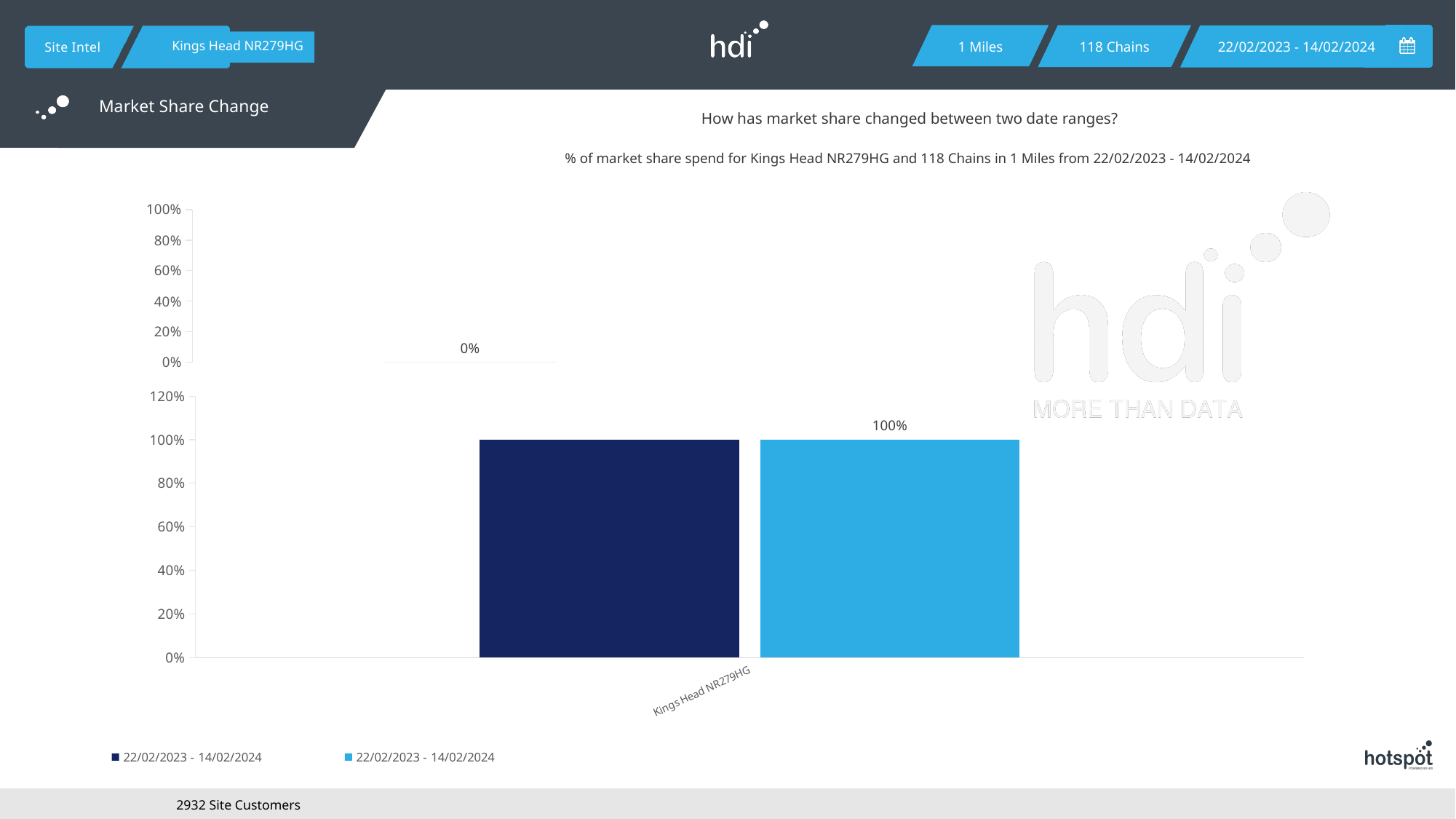
What is the category label shown on the x axis of the lower chart? Kings Head NR279HG In the lower chart, how many bars are plotted for Kings Head NR279HG? 2 In the upper chart, what value is printed as the data label? 0% In the lower chart, is the value of the dark blue bar for Kings Head NR279HG greater or less than 60%? greater In the lower chart, what value is printed above the light blue bar for Kings Head NR279HG? 100% What date range is shown for both entries in the legend? 22/02/2023 - 14/02/2024 In the lower chart, how many categories are shown on the x axis? 1 In the lower chart, is the value of the light blue bar for Kings Head NR279HG greater or less than 80%? greater How many series does the legend at the bottom of the slide list? 2 What kind of chart is the lower chart on the slide? bar chart